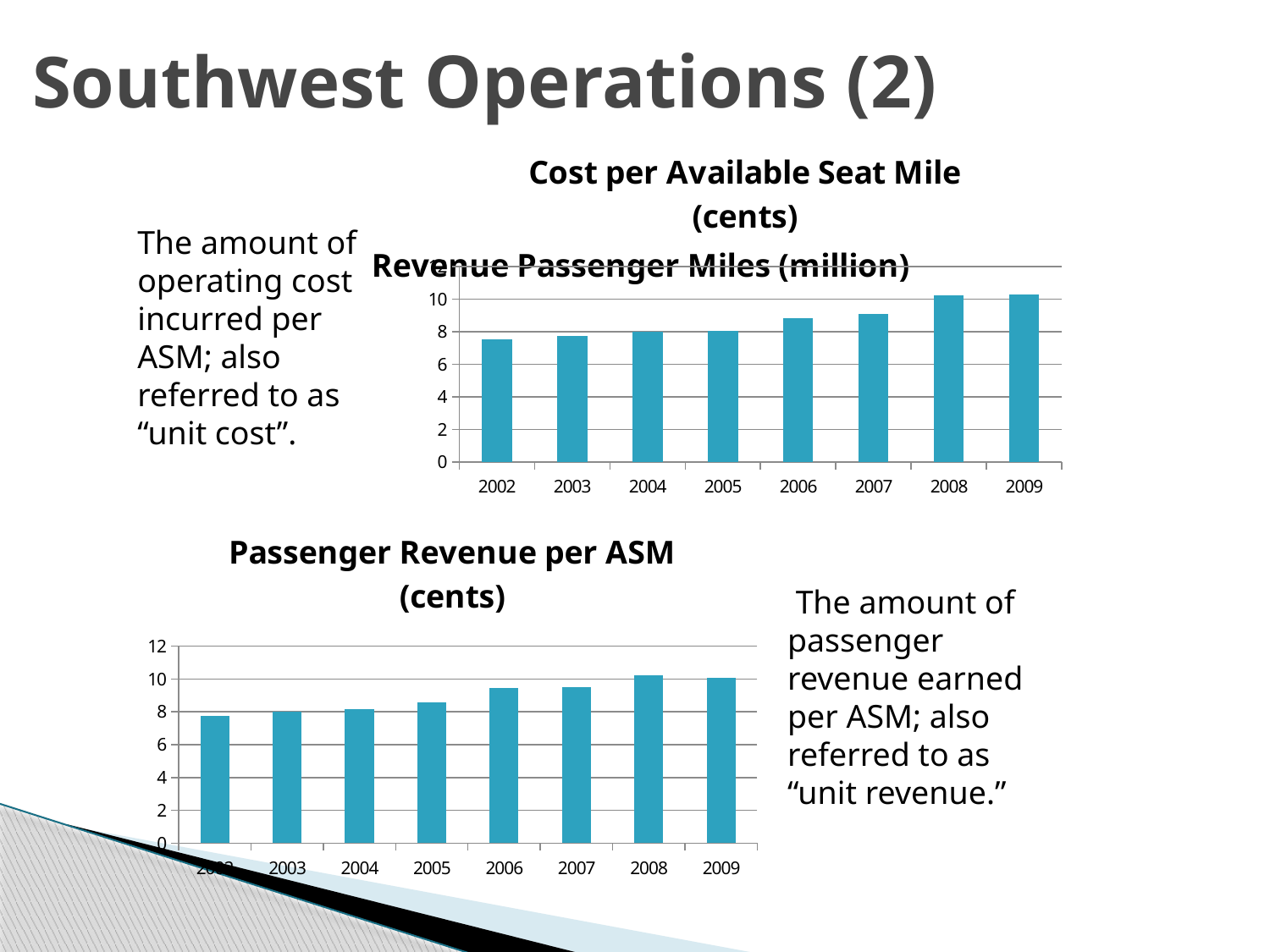
Do the values in the "Cost per Available Seat Mile (cents)" chart generally rise or fall from 2002 to 2009? rise In the "Cost per Available Seat Mile (cents)" chart, is the value for 2008 greater or less than 10? greater In the "Cost per Available Seat Mile (cents)" chart, is the value for 2002 greater or less than 8? less What is the first year shown on the x axis of the "Cost per Available Seat Mile (cents)" chart? 2002 Do the values in the "Passenger Revenue per ASM (cents)" chart generally rise or fall from 2002 to 2009? rise How many years are shown on the x axis of the "Passenger Revenue per ASM (cents)" chart? 8 What kind of chart is the "Cost per Available Seat Mile (cents)" chart? bar chart In the "Cost per Available Seat Mile (cents)" chart, is the value for 2007 greater or less than 10? less In the "Cost per Available Seat Mile (cents)" chart, which is larger, the value for 2002 or the value for 2008? 2008 In the "Passenger Revenue per ASM (cents)" chart, which is larger, the value for 2003 or the value for 2006? 2006